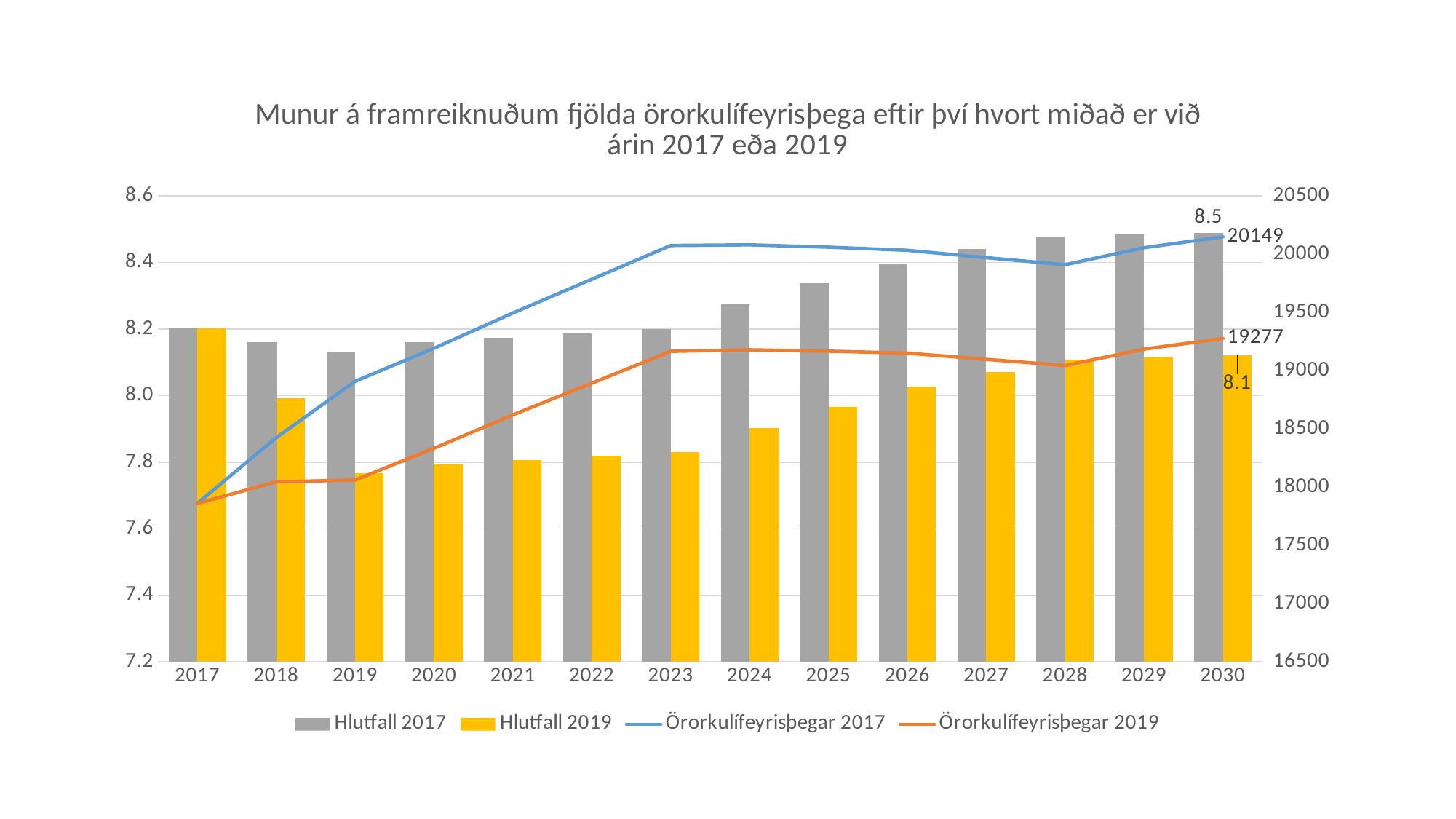
What is the difference between Örorkulífeyrisþegar 2017 and Örorkulífeyrisþegar 2019 in 2030? 872 Does the Örorkulífeyrisþegar 2017 line rise or fall from 2017 to 2023? rise What is the difference between Hlutfall 2017 and Hlutfall 2019 in 2030? 0.4 What is the value of Örorkulífeyrisþegar 2019 in 2030? 19277 What is the value of Örorkulífeyrisþegar 2017 in 2030? 20149 In 2025, which is larger: Hlutfall 2017 or Hlutfall 2019? Hlutfall 2017 Is the value for Hlutfall 2017 in 2024 greater or less than 8.2? greater What is the value of Hlutfall 2017 in 2030? 8.5 How many years are shown on the x axis? 14 What is the value of Hlutfall 2019 in 2030? 8.1 How many series does the legend list? 4 What kind of chart is shown on the slide? Combined bar and line chart